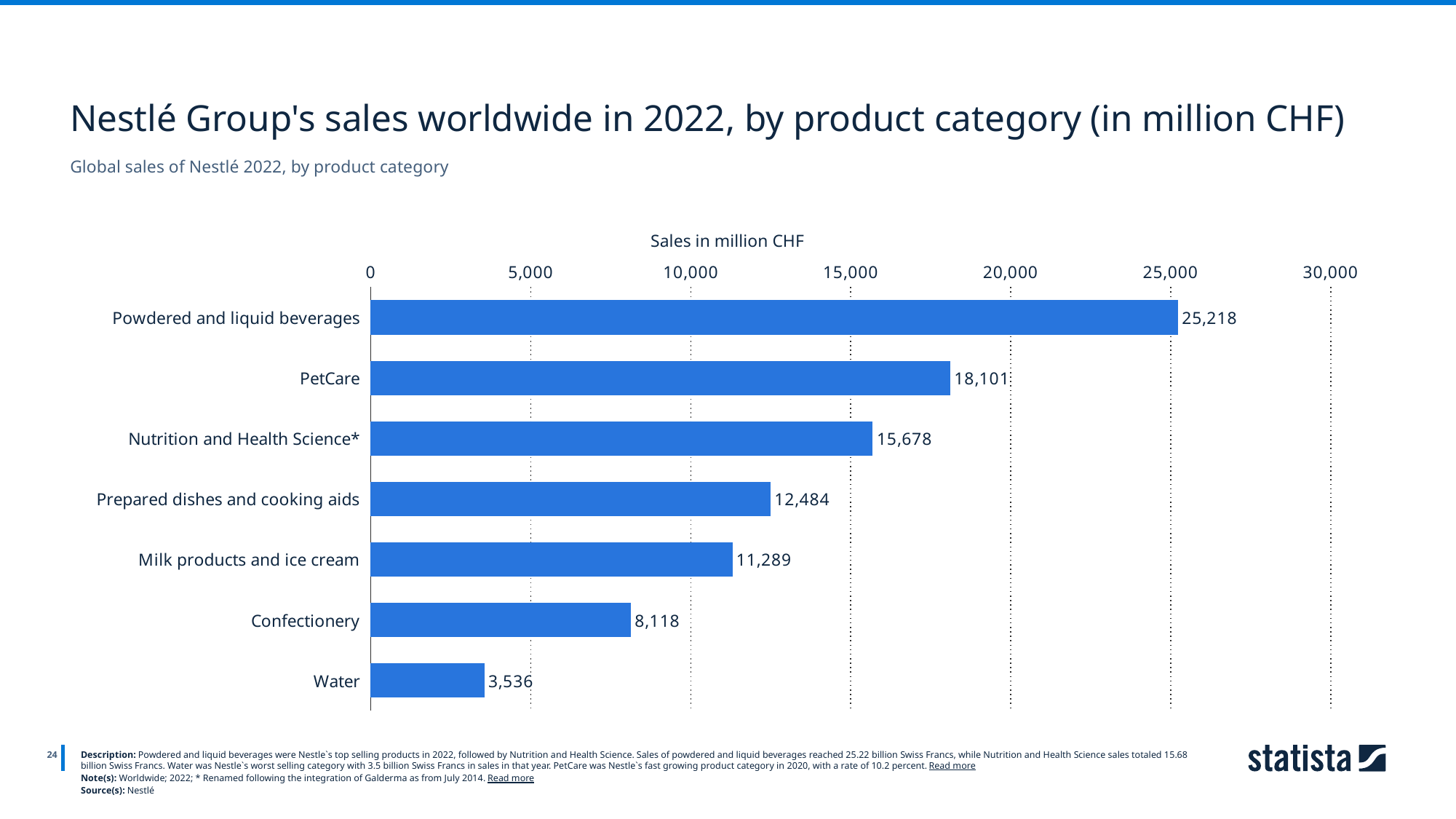
What is the difference between the sales of Prepared dishes and cooking aids and Milk products and ice cream? 1,195 Which product category has the lowest sales? Water Is the value for Milk products and ice cream greater or less than 10,000? greater What kind of chart is shown on the slide? Bar chart What is the value shown for Confectionery? 8,118 What is the label of the horizontal axis? Sales in million CHF What were Nestlé's sales for PetCare in 2022, in million CHF? 18,101 How many product categories are shown in the chart? 7 Which product category has the highest sales? Powdered and liquid beverages What is the value shown for Water? 3,536 Which has higher sales, Nutrition and Health Science* or Confectionery? Nutrition and Health Science* What is the difference between the sales of Powdered and liquid beverages and PetCare? 7,117